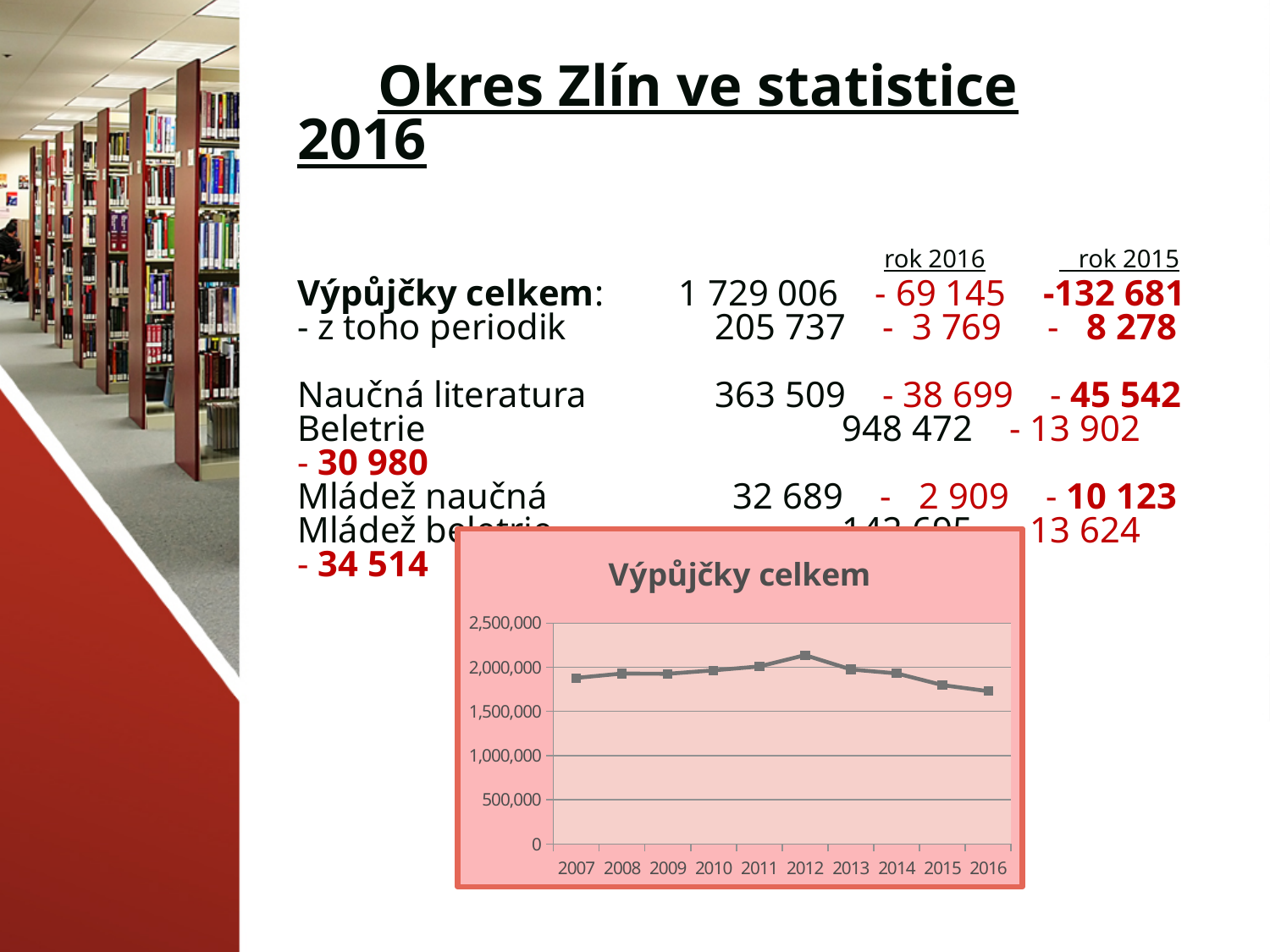
Which year has the highest value in the chart? 2012 Which year has the larger value, 2012 or 2016? 2012 What is the title of the chart? Výpůjčky celkem Is the value for 2012 greater or less than 2,000,000? greater How many years are plotted on the x axis of the chart? 10 Do the values rise or fall from 2012 to 2016? fall What kind of chart is shown on the slide? line chart Is the value for 2016 greater or less than 2,000,000? less What is the first year shown on the x axis of the chart? 2007 Which year has the larger value, 2007 or 2012? 2012 Which year has the lowest value in the chart? 2016 Is the value for 2007 greater or less than 1,500,000? greater